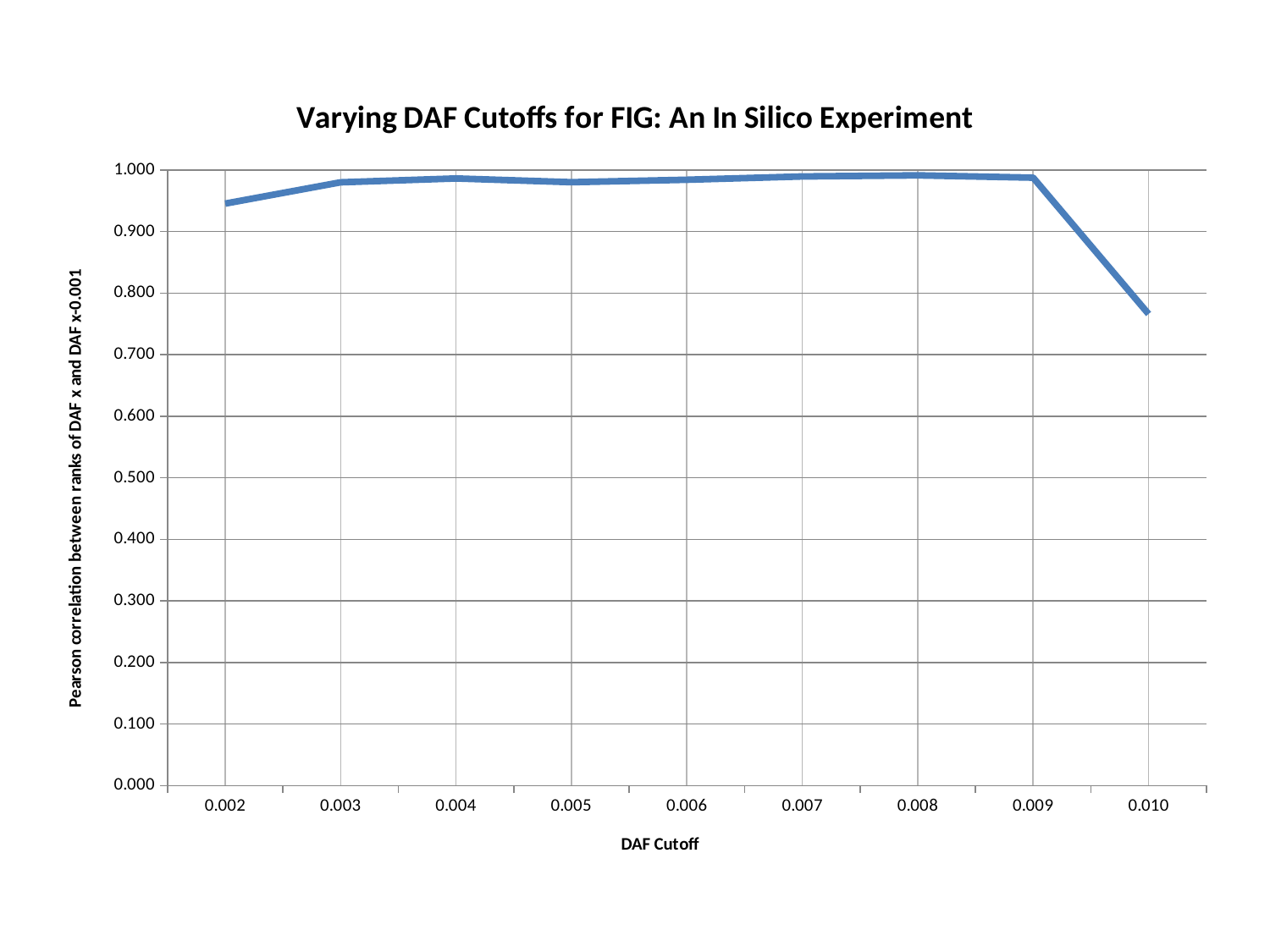
Is the value at DAF cutoff 0.002 greater or less than 0.900? greater Does the Pearson correlation rise or fall between DAF cutoff 0.002 and 0.003? rise What kind of chart is shown on the slide? line chart How many DAF cutoff values are plotted on the x axis? 9 Does the Pearson correlation rise or fall between DAF cutoff 0.009 and 0.010? fall What is the label of the x axis? DAF Cutoff Is the value at DAF cutoff 0.006 greater or less than 0.900? greater Is the value at DAF cutoff 0.010 greater or less than 0.800? less At which DAF cutoff is the Pearson correlation lowest? 0.010 Which has the larger Pearson correlation, DAF cutoff 0.002 or DAF cutoff 0.010? 0.002 What is the title of the chart? Varying DAF Cutoffs for FIG: An In Silico Experiment